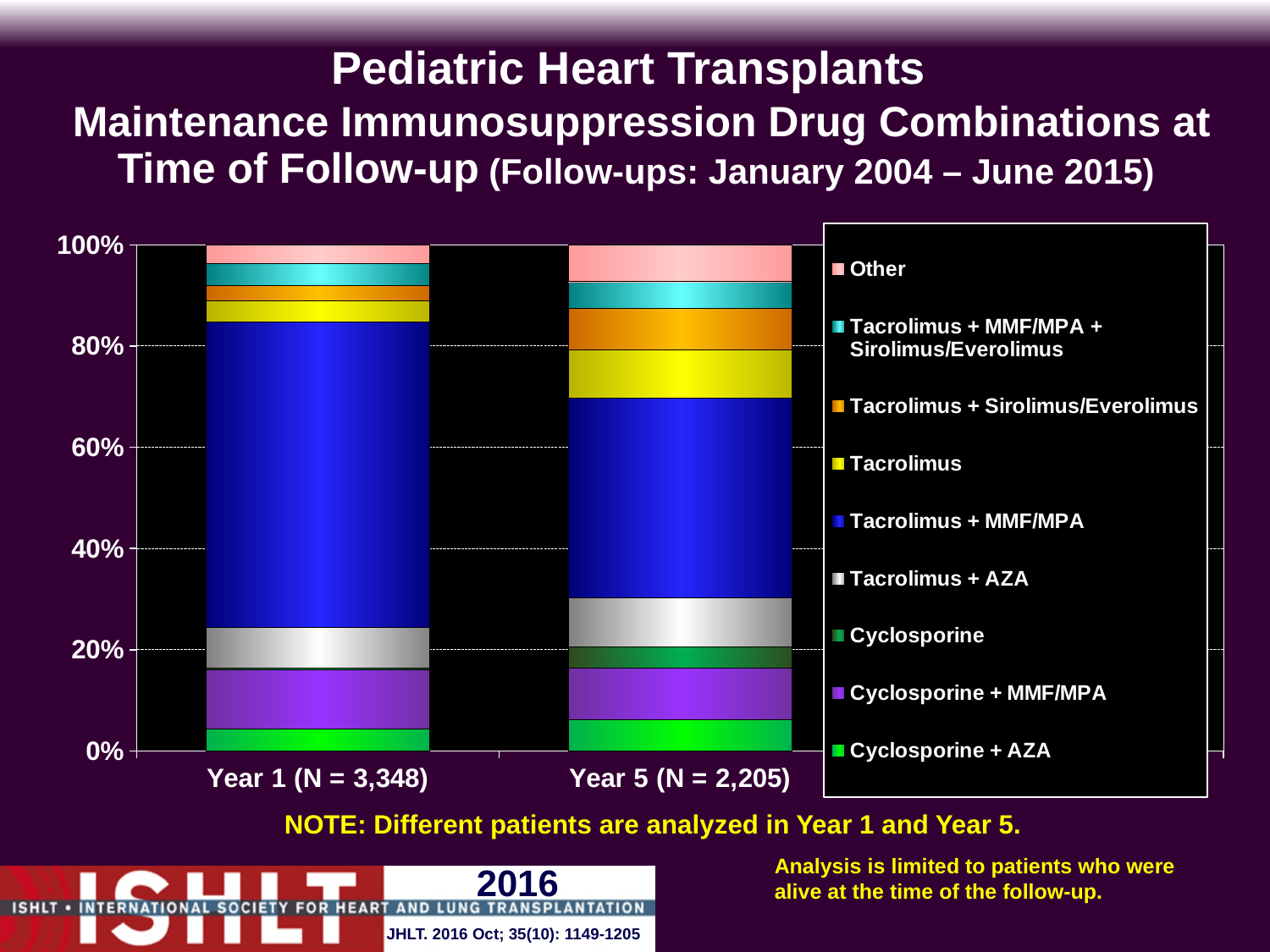
What is the N shown for the Year 1 bar? 3,348 How many bars (categories) are plotted on the x axis? 2 How many drug combination series does the legend list? 9 What is the total height of the Year 1 stacked bar? 100% Which bar has the larger Tacrolimus (alone) segment, Year 1 or Year 5? Year 5 Which bar has the larger Tacrolimus + MMF/MPA segment, Year 1 or Year 5? Year 1 Is the top of the Tacrolimus + MMF/MPA segment in the Year 5 bar greater or less than 80%? less Is the top of the Tacrolimus + MMF/MPA segment in the Year 1 bar greater or less than 80%? greater Is the top of the Cyclosporine + MMF/MPA segment in the Year 1 bar greater or less than 20%? less What kind of chart is shown on the slide? Stacked bar chart Which legend entry is listed at the top of the legend? Other What is the N shown for the Year 5 bar? 2,205